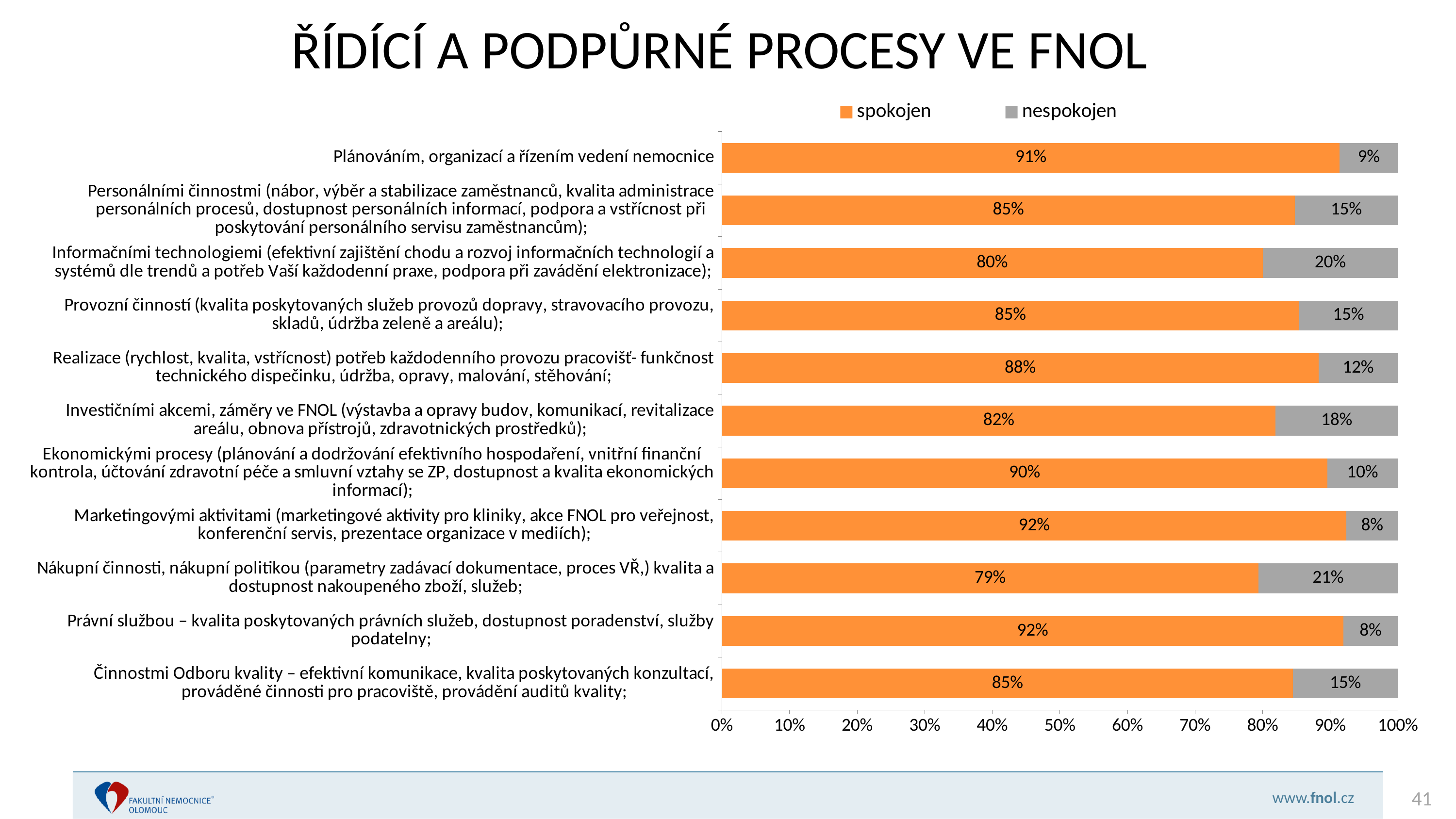
What is the total of the stacked bar for 'Právní službou'? 100% Which category has the highest 'nespokojen' value? Nákupní činnosti, nákupní politikou What is the 'spokojen' value for 'Plánováním, organizací a řízením vedení nemocnice'? 91% Which colour represents the 'nespokojen' series? grey What is the 'nespokojen' value for 'Informačními technologiemi'? 20% Which category has the lowest 'spokojen' value? Nákupní činnosti, nákupní politikou How many categories (processes) are plotted in the chart? 11 Which has a larger 'spokojen' value: 'Realizace potřeb každodenního provozu pracovišť' or 'Provozní činností'? Realizace potřeb každodenního provozu pracovišť How many series does the legend list? 2 What is the 'spokojen' value for 'Ekonomickými procesy'? 90% What type of chart is shown on the slide? stacked bar chart What is the difference between the 'spokojen' values for 'Marketingovými aktivitami' and 'Investičními akcemi'? 10%